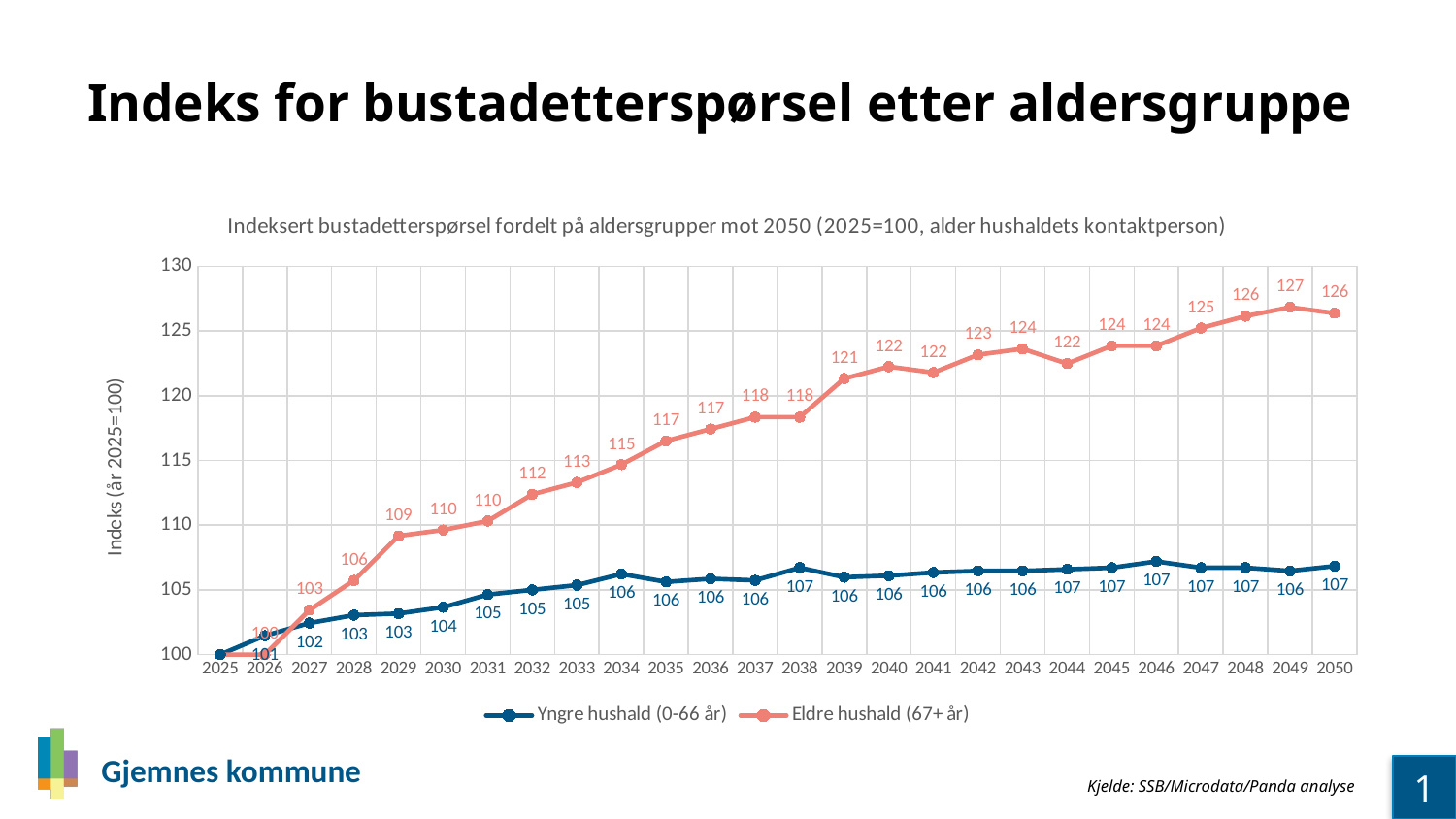
What is the value for Eldre hushald (67+ år) in 2039? 121 Is the value for Eldre hushald (67+ år) in 2034 greater or less than 110? greater What is the label of the y axis? Indeks (år 2025=100) What is the value for Eldre hushald (67+ år) in 2049? 127 How many years are plotted on the x axis? 26 What is the difference between Eldre hushald (67+ år) and Yngre hushald (0-66 år) in 2050? 19 Does the Eldre hushald (67+ år) series generally rise or fall from 2025 to 2050? Rise How many series does the legend list? 2 What is the value for Yngre hushald (0-66 år) in 2030? 104 Which series has the larger value in 2040, Yngre hushald (0-66 år) or Eldre hushald (67+ år)? Eldre hushald (67+ år) In which year does Eldre hushald (67+ år) reach its highest value? 2049 What kind of chart is shown on the slide? Line chart